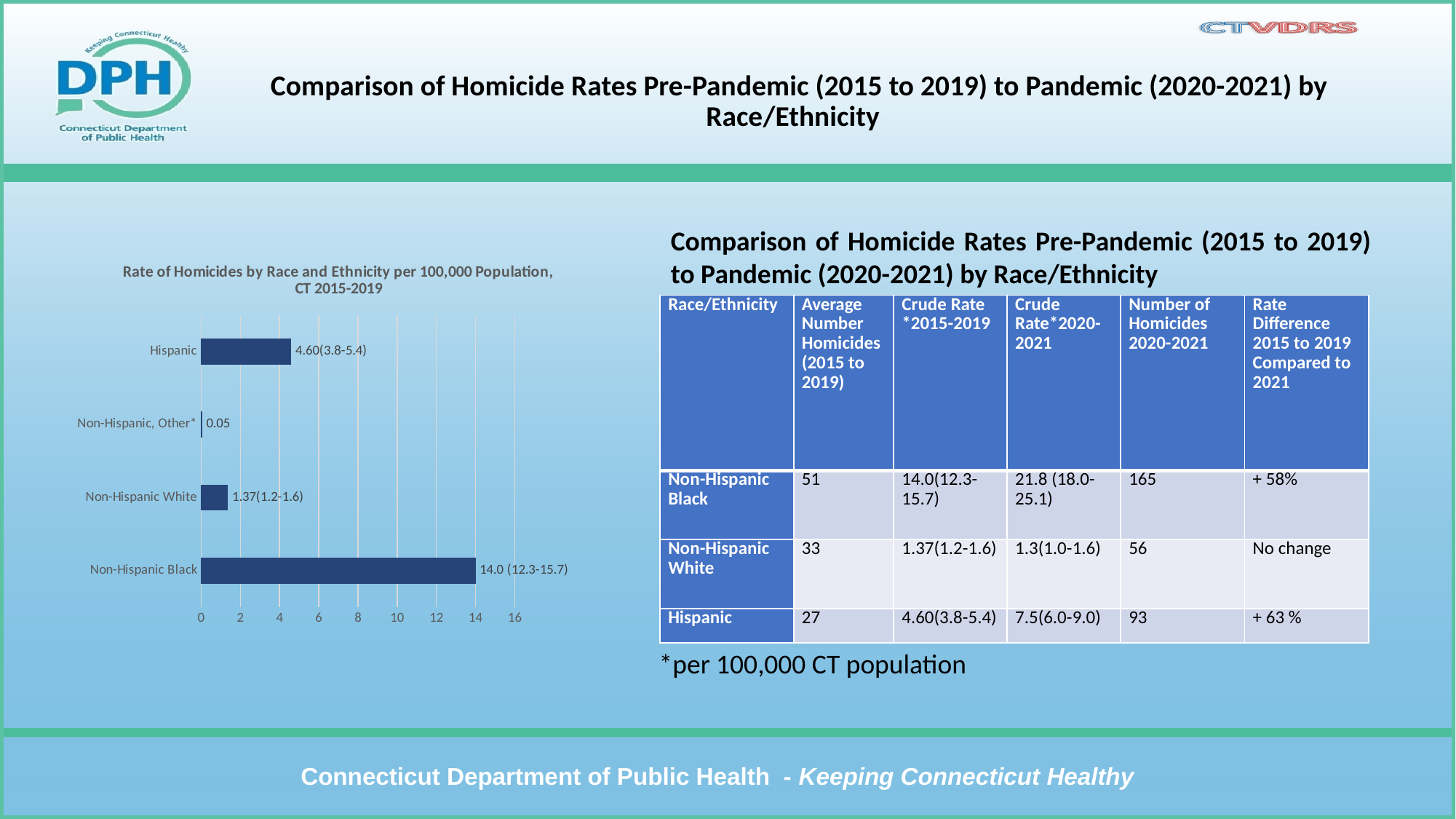
Is the homicide rate for Non-Hispanic Black in the chart greater or less than 10? greater What is the homicide rate shown for Non-Hispanic White in the chart? 1.37(1.2-1.6) What is the maximum value shown on the x axis of the chart? 16 Which category has the highest homicide rate in the chart? Non-Hispanic Black How many race/ethnicity categories are plotted in the chart? 4 What is the title of the chart on the slide? Rate of Homicides by Race and Ethnicity per 100,000 Population, CT 2015-2019 Which has a higher homicide rate in the chart, Hispanic or Non-Hispanic White? Hispanic Which category has the lowest homicide rate in the chart? Non-Hispanic, Other* What type of chart is shown on the slide? Bar chart What is the homicide rate shown for Hispanic in the chart? 4.60(3.8-5.4) What is the homicide rate shown for Non-Hispanic Black in the chart? 14.0 (12.3-15.7) What is the value shown for Non-Hispanic, Other* in the chart? 0.05